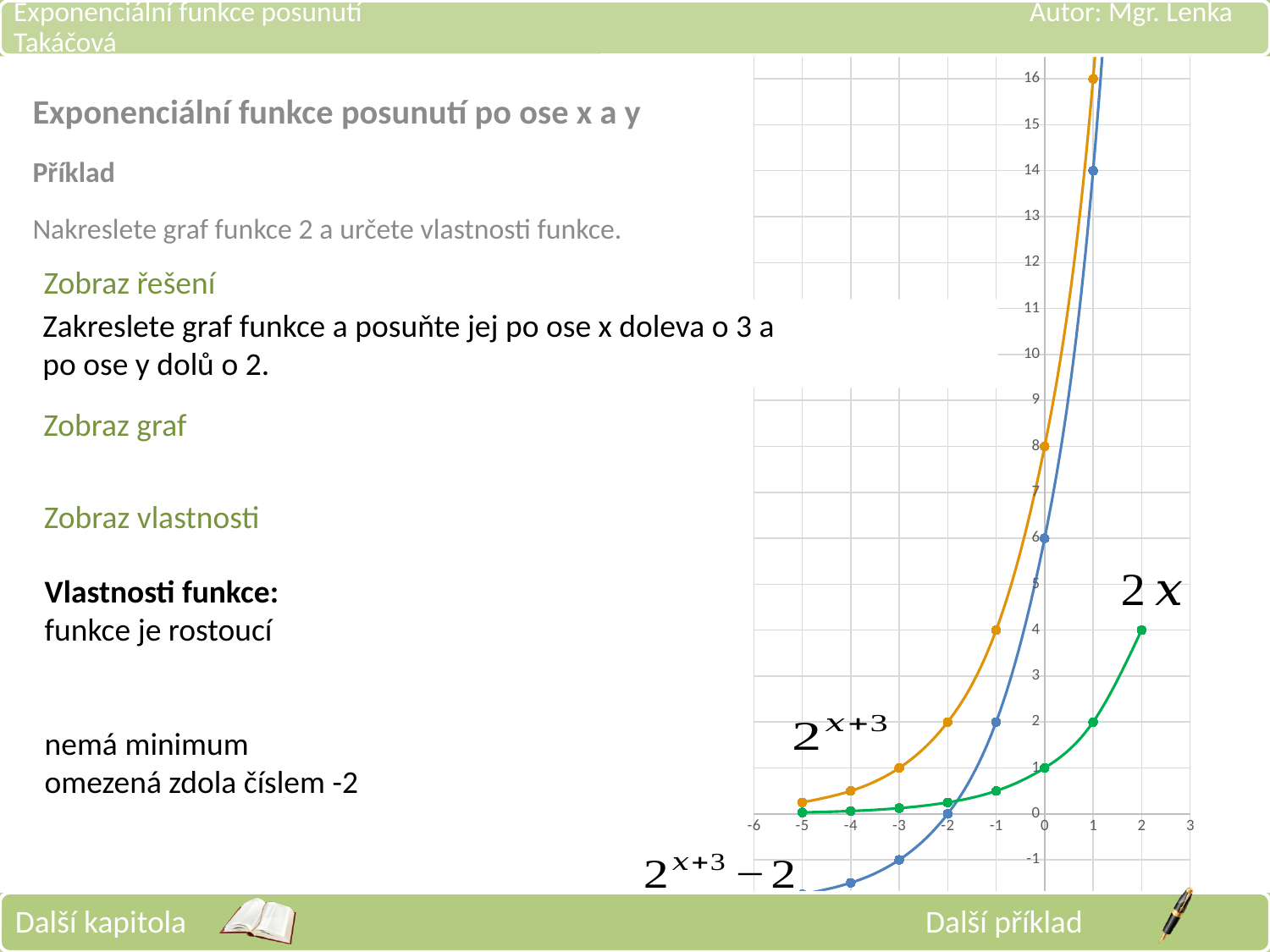
At x = 1, what is the difference between the values of 2^(x+3) and 2^(x+3) − 2? 2 Is the value of the curve 2^(x+3) − 2 at x = 1 greater or less than 10? greater What is the value of the curve 2^(x+3) at x = -3? 1 What is the value of the curve 2^(x+3) − 2 at x = 0? 6 What is the highest value labelled on the y axis? 16 What colour is the curve labelled 2^x? green What is the value of the curve 2^(x+3) at x = 1? 16 What is the value of the curve 2^x at x = 2? 4 Do the plotted curves rise or fall as x increases? rise At x = 0, which curve is higher: 2^(x+3) or 2^x? 2^(x+3) What kind of chart is shown on the slide? line chart How many curves are plotted on the chart? 3